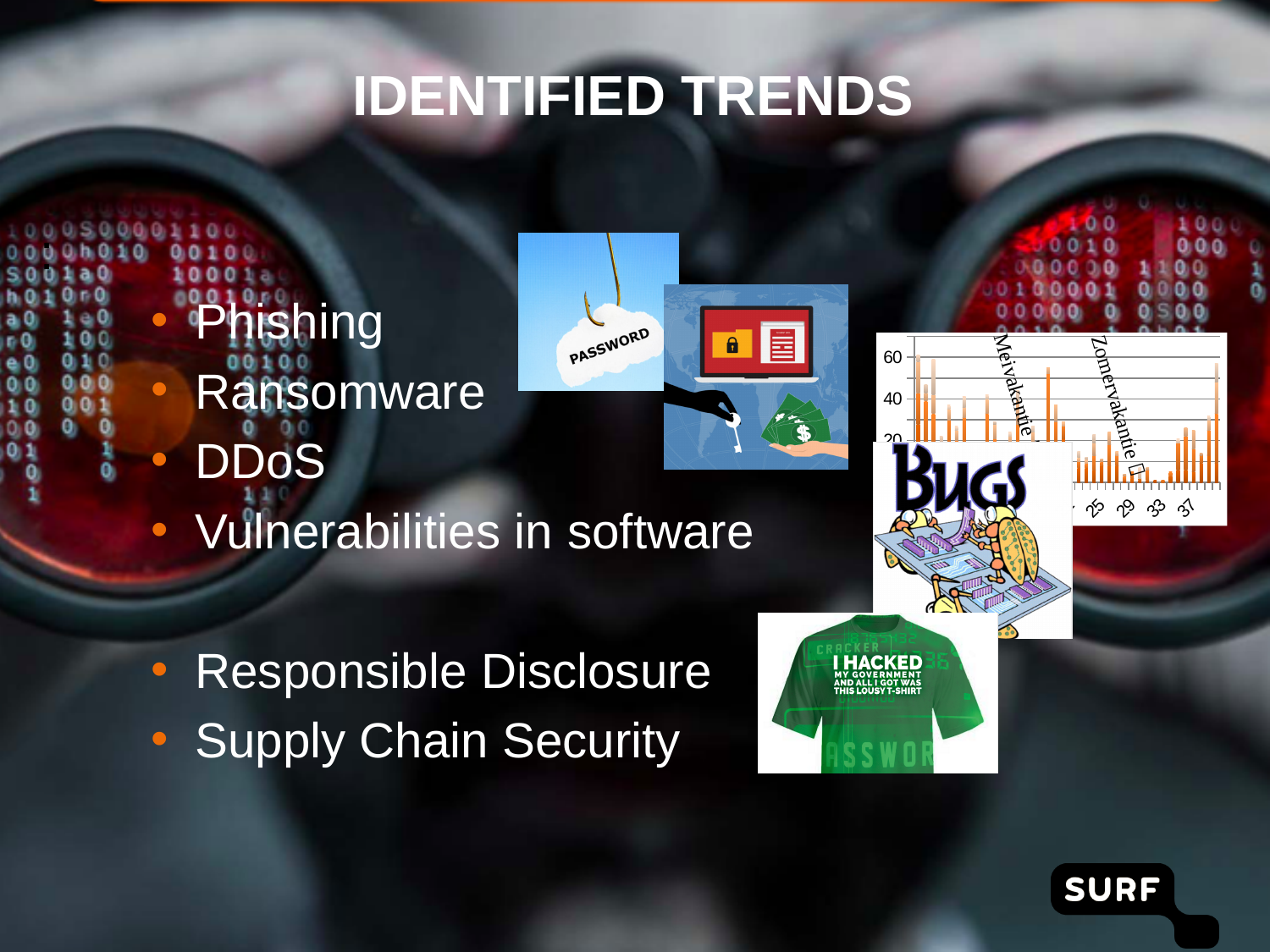
What kind of chart is shown on the right side of the slide? bar chart Which two text annotations are written across the chart on the right side of the slide? Meivakantie and Zomervakantie In the chart on the right side of the slide, is the value of the tallest bar greater or less than 40? greater What colour are the bars in the chart on the right side of the slide? orange